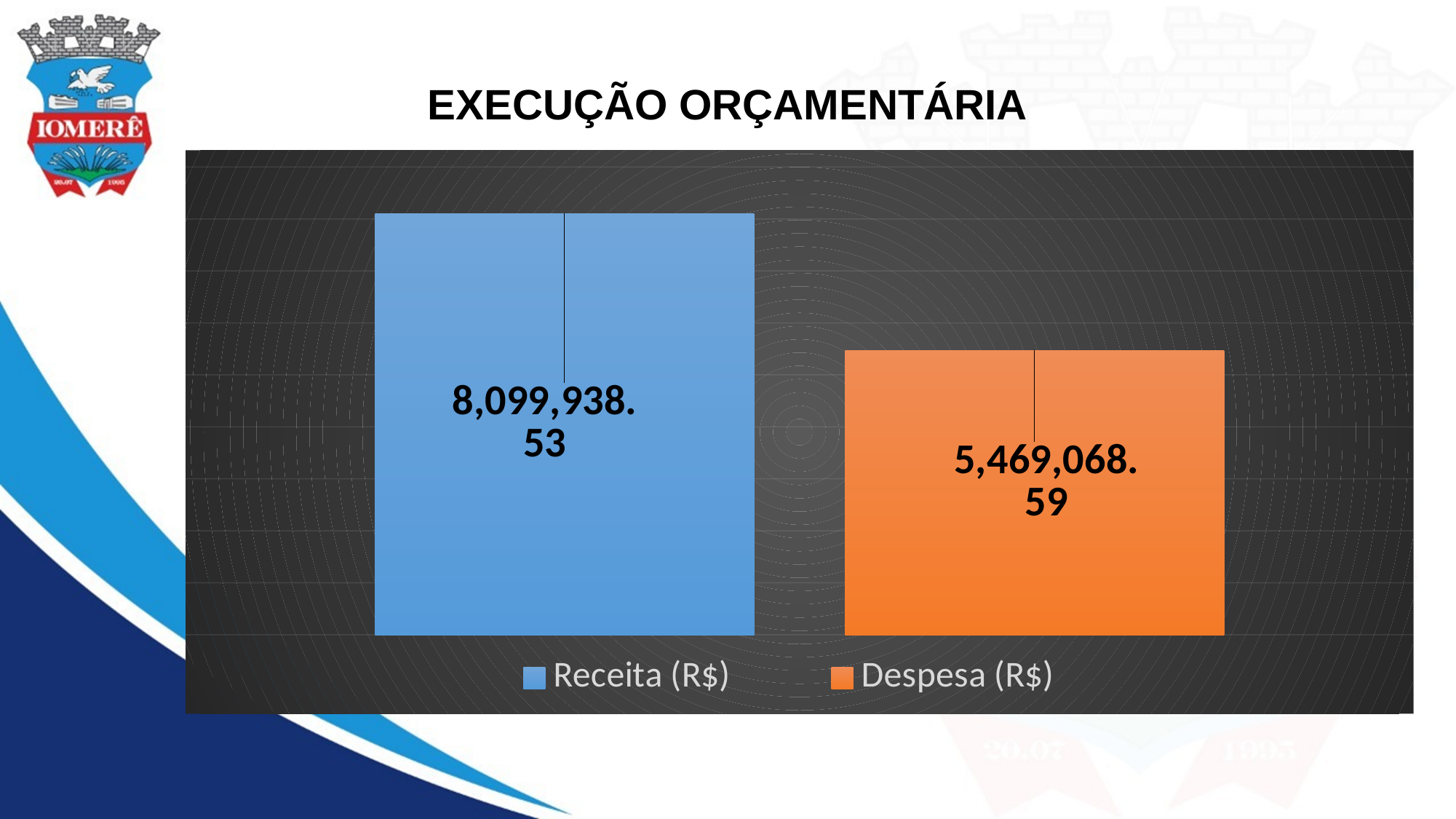
What kind of chart is shown on the slide? Bar chart What colour is the bar for Despesa (R$)? Orange What is the value of Despesa (R$) in the chart? 5,469,068.59 How many series does the legend list? 2 How many bars are plotted in the chart? 2 Which is larger, Receita (R$) or Despesa (R$)? Receita (R$) What is the title of the slide above the chart? EXECUÇÃO ORÇAMENTÁRIA What is the difference between Receita (R$) and Despesa (R$)? 2,630,869.94 Which series has the lowest value in the chart? Despesa (R$) Which series has the highest value in the chart? Receita (R$) What is the value of Receita (R$) in the chart? 8,099,938.53